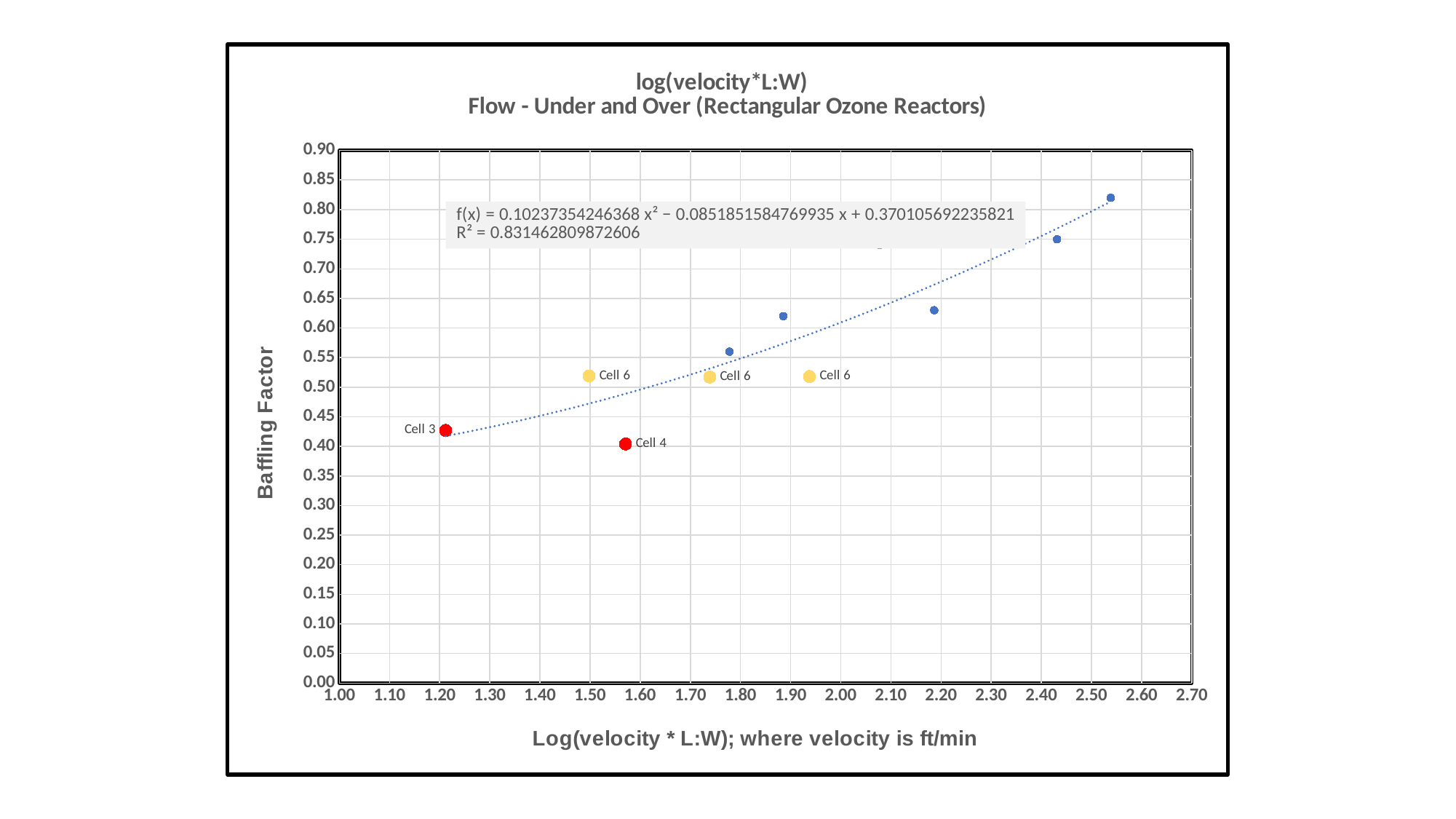
What is the title of the chart? log(velocity*L:W) Flow - Under and Over (Rectangular Ozone Reactors) How many data points are plotted on the chart in total? 11 What kind of chart is shown on the slide? scatter chart What R² value is printed on the chart for the trendline? 0.831462809872606 How many points are labelled "Cell 6"? 3 Do the plotted Baffling Factor values generally rise or fall as Log(velocity * L:W) increases? rise What is the label of the vertical axis? Baffling Factor Is the Baffling Factor for the point labelled Cell 3 greater or less than 0.50? less Is the Baffling Factor for the point labelled Cell 4 greater or less than 0.50? less Which has the higher Baffling Factor, the point labelled Cell 4 or the points labelled Cell 6? Cell 6 Is the Baffling Factor of the highest plotted point greater or less than 0.80? greater Which labelled point has the lowest Baffling Factor? Cell 4